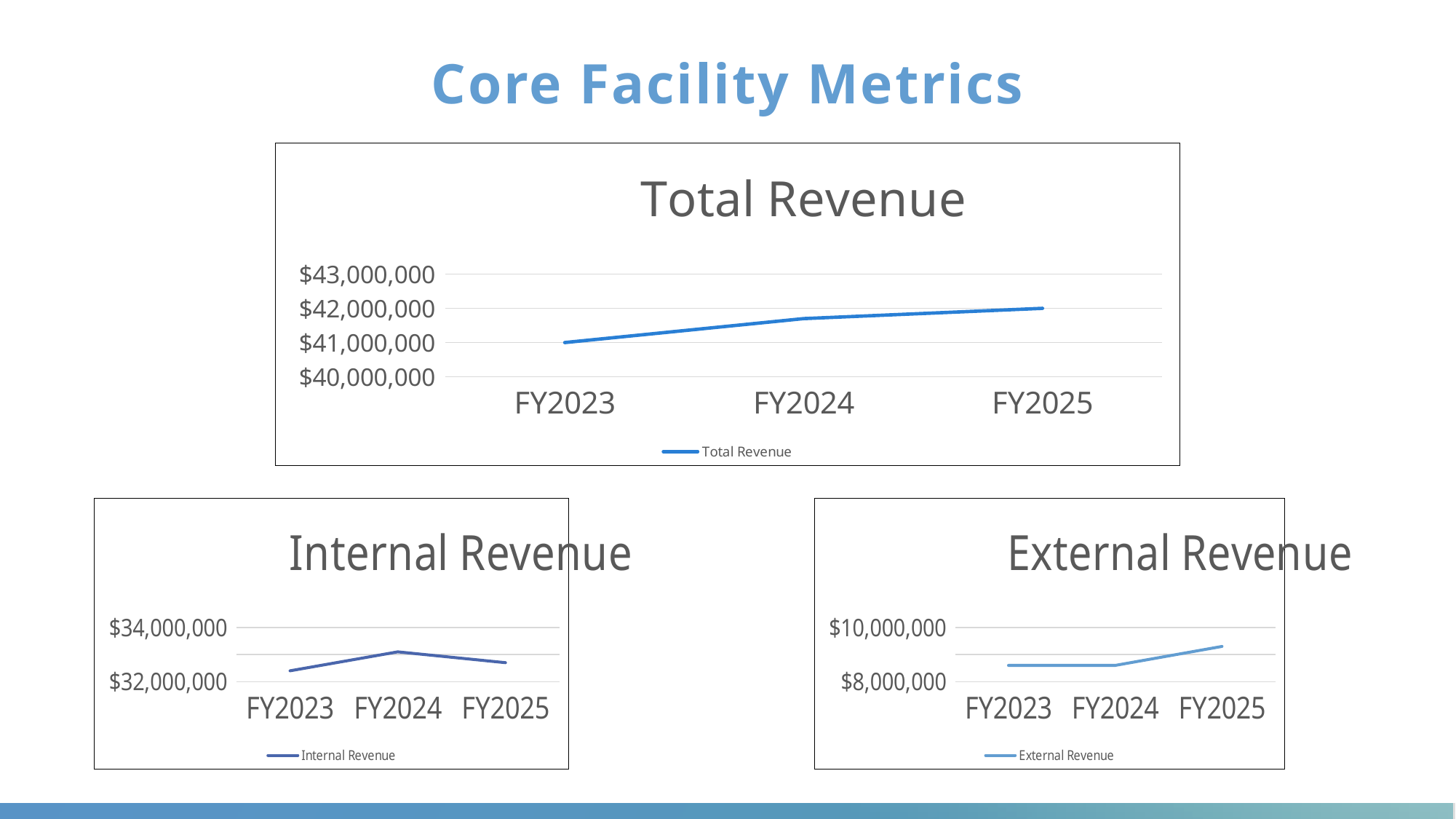
On the Total Revenue chart, which fiscal year has the lowest value? FY2023 On the Internal Revenue chart, which fiscal year has the highest value? FY2024 On the External Revenue chart, is the value for FY2025 greater or less than $10,000,000? less How many fiscal years are plotted on the Total Revenue chart? 3 On the Total Revenue chart, which fiscal year has the highest value? FY2025 On the Total Revenue chart, is the value for FY2024 greater or less than $41,000,000? greater On the Internal Revenue chart, is the value for FY2024 greater or less than $32,000,000? greater On the External Revenue chart, which fiscal year has the highest value? FY2025 What kind of chart is the Total Revenue chart? line chart On the Internal Revenue chart, which fiscal year has the lowest value? FY2023 How many series does the legend of the External Revenue chart list? 1 On the Total Revenue chart, does the value rise or fall from FY2023 to FY2025? rise